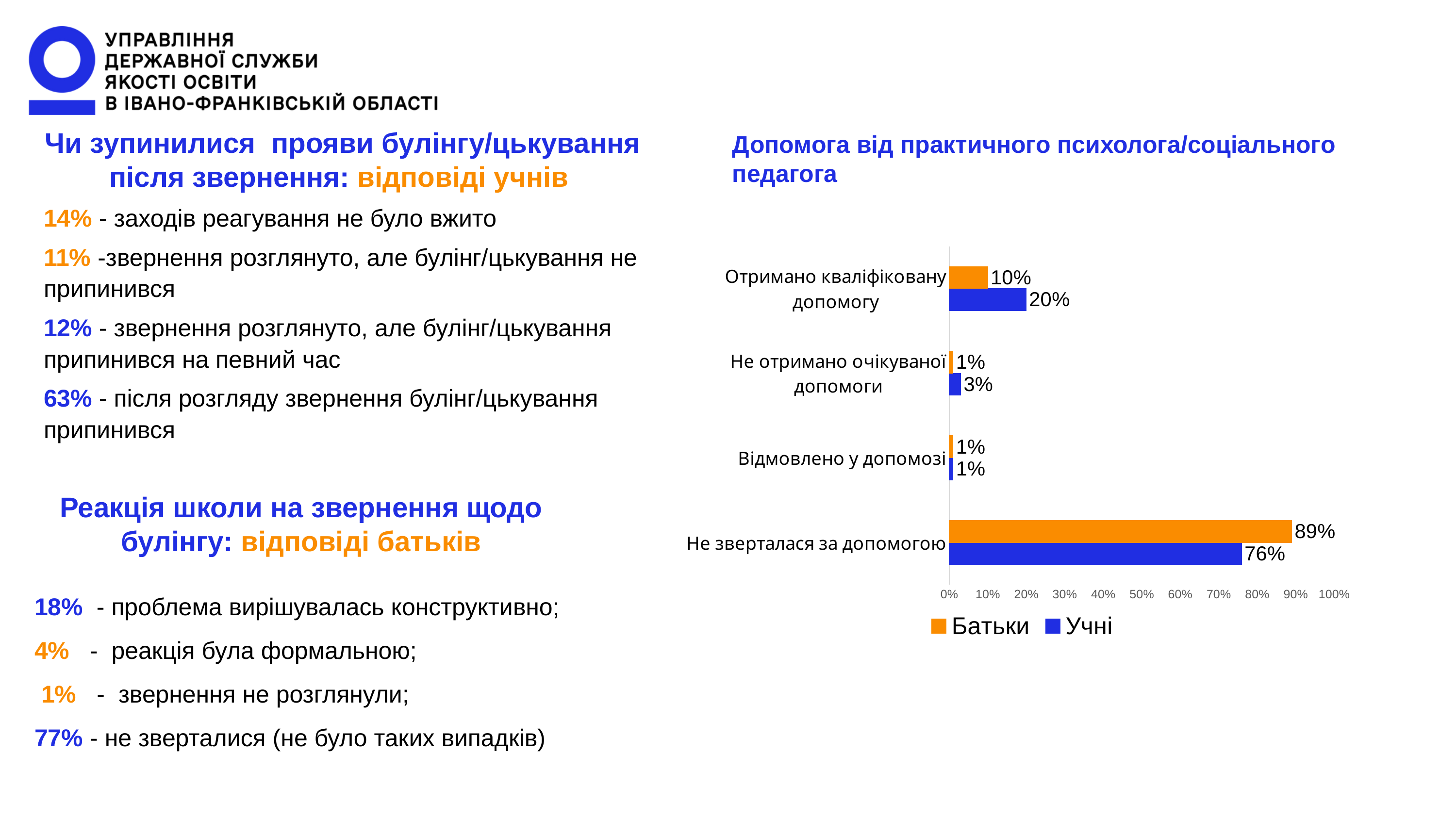
What kind of chart is shown on the slide? bar chart What is the value for Батьки in the category 'Відмовлено у допомозі'? 1% In the category 'Отримано кваліфіковану допомогу', which series has the larger value, Батьки or Учні? Учні What is the value for Учні in the category 'Не отримано очікуваної допомоги'? 3% What is the value for Учні in the category 'Отримано кваліфіковану допомогу'? 20% Which series is shown in orange in the chart legend? Батьки How many categories are shown in the chart? 4 Which category has the highest value for Учні? Не зверталася за допомогою Which category has the lowest value for Батьки? Не отримано очікуваної допомоги and Відмовлено у допомозі (both 1%) How many series does the chart legend list? 2 What is the value for Батьки in the category 'Не зверталася за допомогою'? 89% What is the difference between the Батьки and Учні values in the category 'Не зверталася за допомогою'? 13%